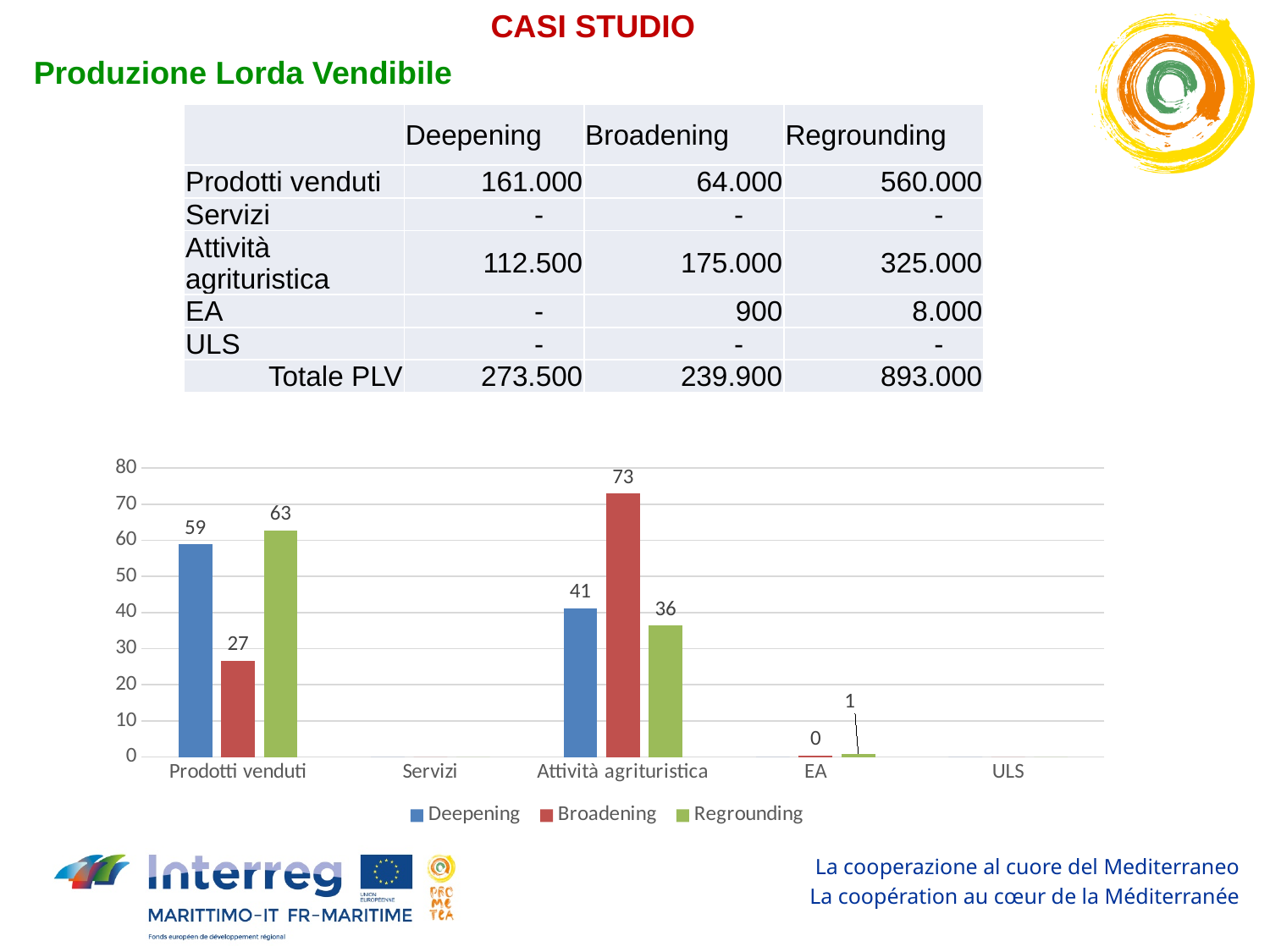
Which is larger: the Deepening value for Prodotti venduti or the Deepening value for Attività agrituristica? Prodotti venduti Which series has the lowest value in the Prodotti venduti category? Broadening Which series has the highest value in the Attività agrituristica category? Broadening What is the value for Deepening in the Prodotti venduti category? 59 What is the value for Regrounding in the EA category? 1 How many categories are shown on the x axis of the chart? 5 What is the value for Regrounding in the Prodotti venduti category? 63 What type of chart is shown on the slide? Bar chart How many series does the chart legend list? 3 What is the value for Broadening in the Attività agrituristica category? 73 What is the difference between the Regrounding and Broadening values in the Prodotti venduti category? 36 Is the Broadening value for Attività agrituristica greater or less than 70? greater